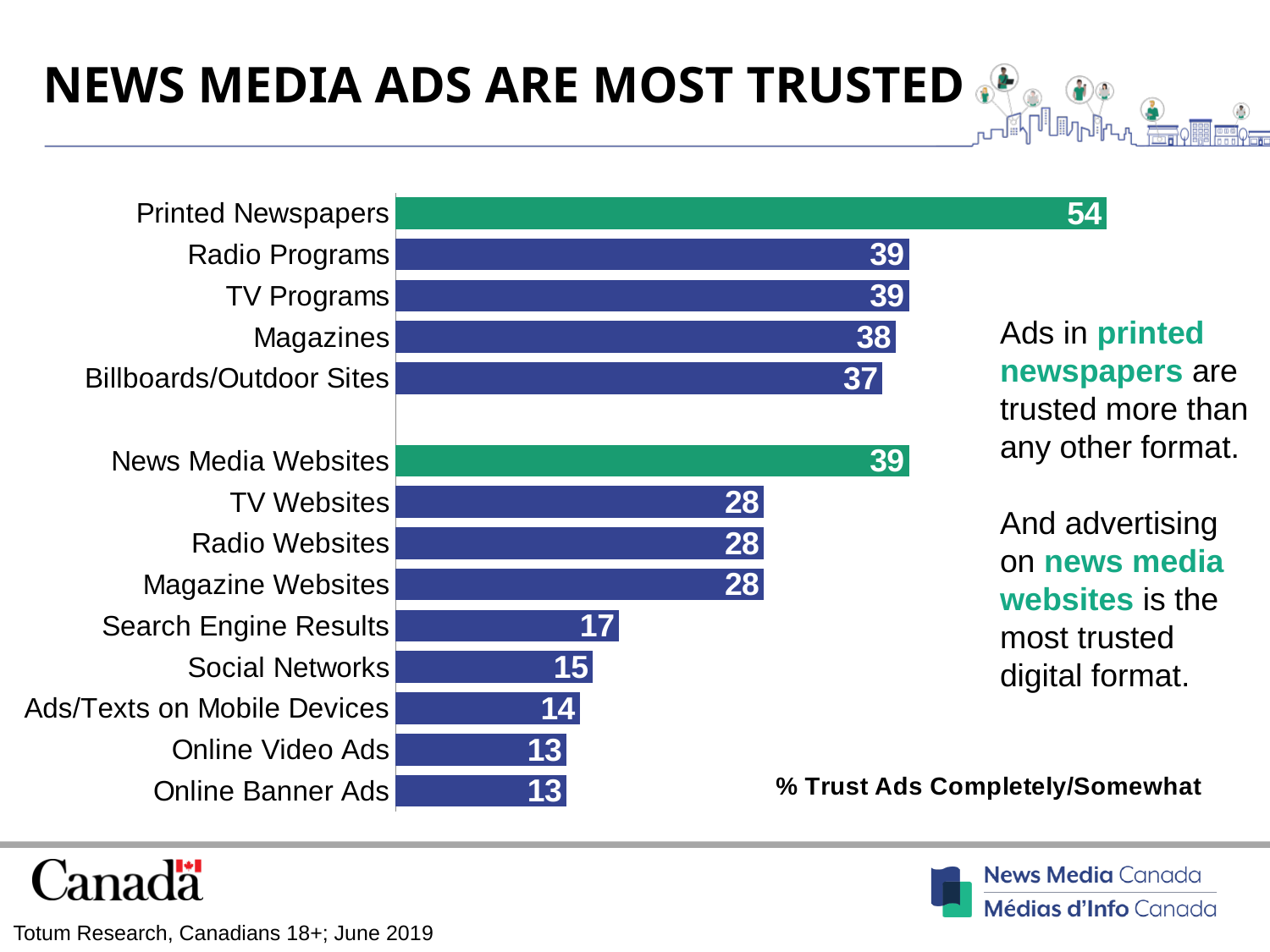
How many categories are shown in the chart? 14 What is the value for News Media Websites? 39 What is the value for Social Networks? 15 What is the difference between the values for Printed Newspapers and News Media Websites? 15 Which is larger, the value for Online Video Ads or the value for Search Engine Results? Search Engine Results What is the difference between the values for Magazines and Ads/Texts on Mobile Devices? 24 What does the label below the chart say the values represent? % Trust Ads Completely/Somewhat What kind of chart is shown on the slide? Bar chart What is the value for Search Engine Results? 17 Which category has the highest value? Printed Newspapers What is the value for Printed Newspapers? 54 Which is larger, the value for Billboards/Outdoor Sites or the value for TV Websites? Billboards/Outdoor Sites